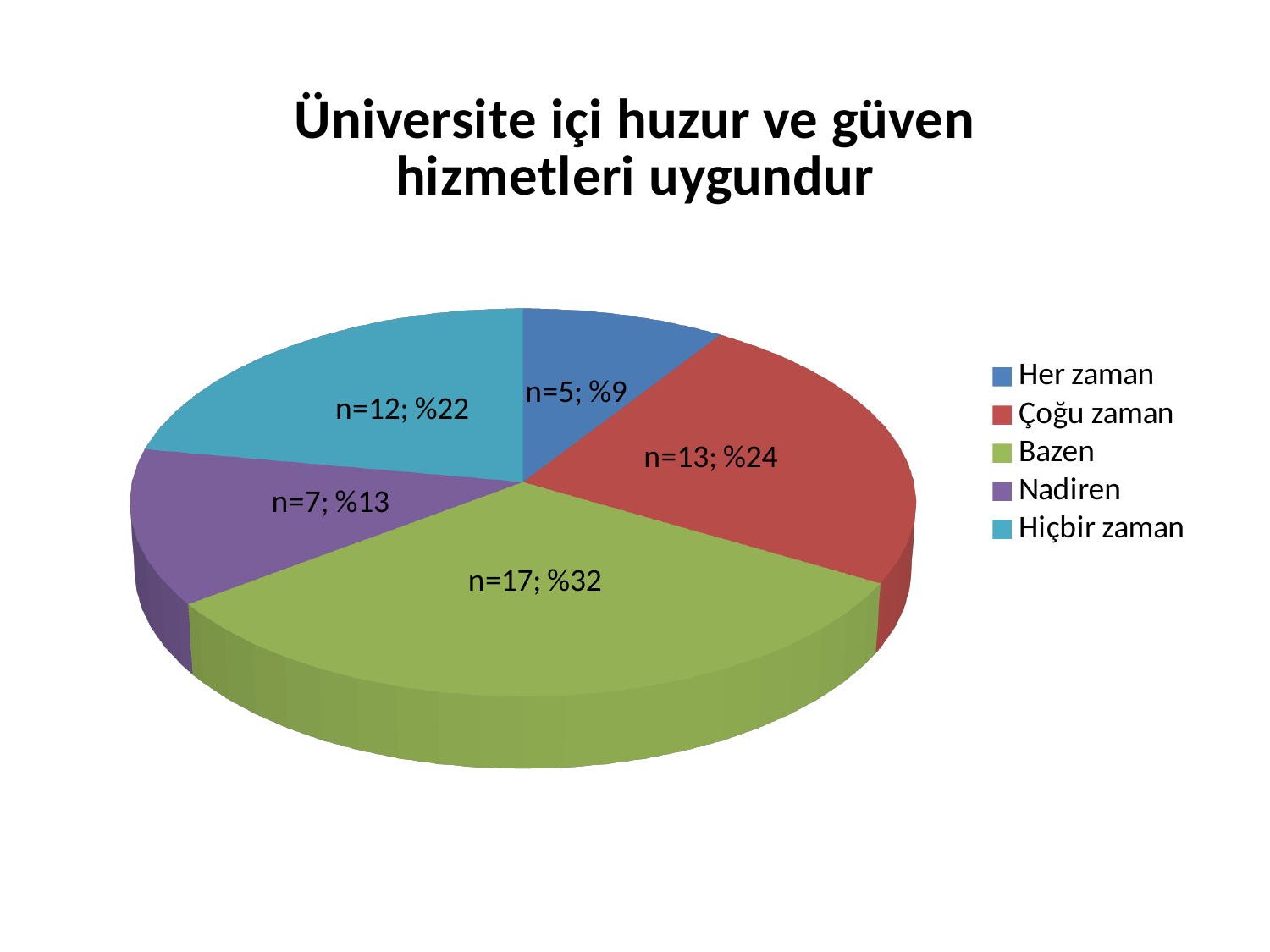
What is the difference in n between Bazen and Nadiren? 10 How many categories does the legend list? 5 What is the data label for the Bazen slice? n=17; %32 What is the title of the chart? Üniversite içi huzur ve güven hizmetleri uygundur What kind of chart is shown on the slide? pie chart Which category has the smallest slice? Her zaman What colour is the Nadiren slice? purple Which category has the largest slice? Bazen What percentage share does the Her zaman slice have? %9 What percentage share does the Hiçbir zaman slice have? %22 Which is larger, the Çoğu zaman slice or the Hiçbir zaman slice? Çoğu zaman What is the n value for Çoğu zaman? 13